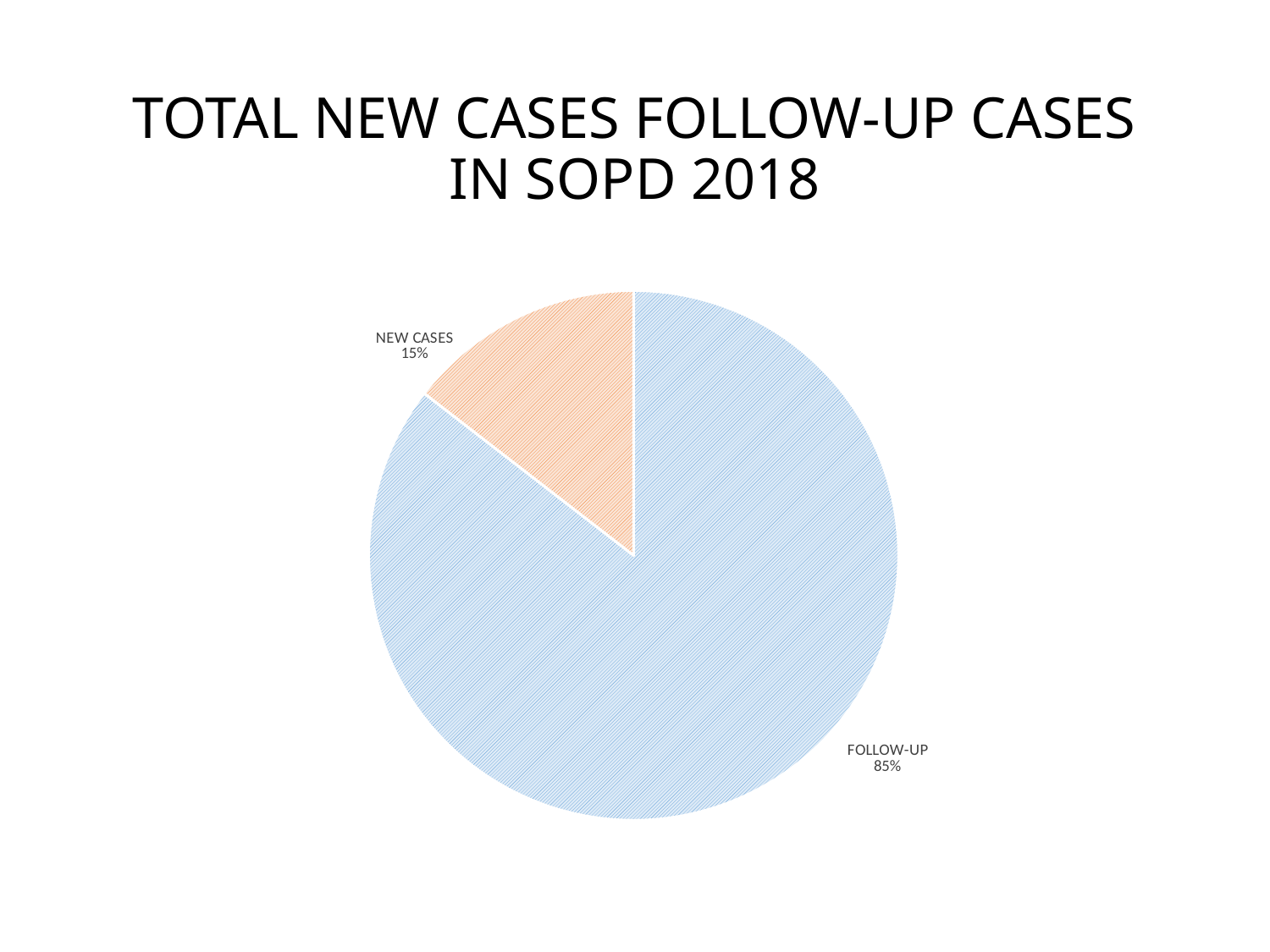
What colour is the FOLLOW-UP slice? blue What share of the pie is FOLLOW-UP? 85% Which slice is the smallest? NEW CASES Which slice is the largest? FOLLOW-UP What is the title of the slide? TOTAL NEW CASES FOLLOW-UP CASES IN SOPD 2018 How many slices does the pie chart have? 2 What share of the pie is NEW CASES? 15% What kind of chart is shown on the slide? pie chart Which is larger, NEW CASES or FOLLOW-UP? FOLLOW-UP What is the difference in percentage points between FOLLOW-UP and NEW CASES? 70